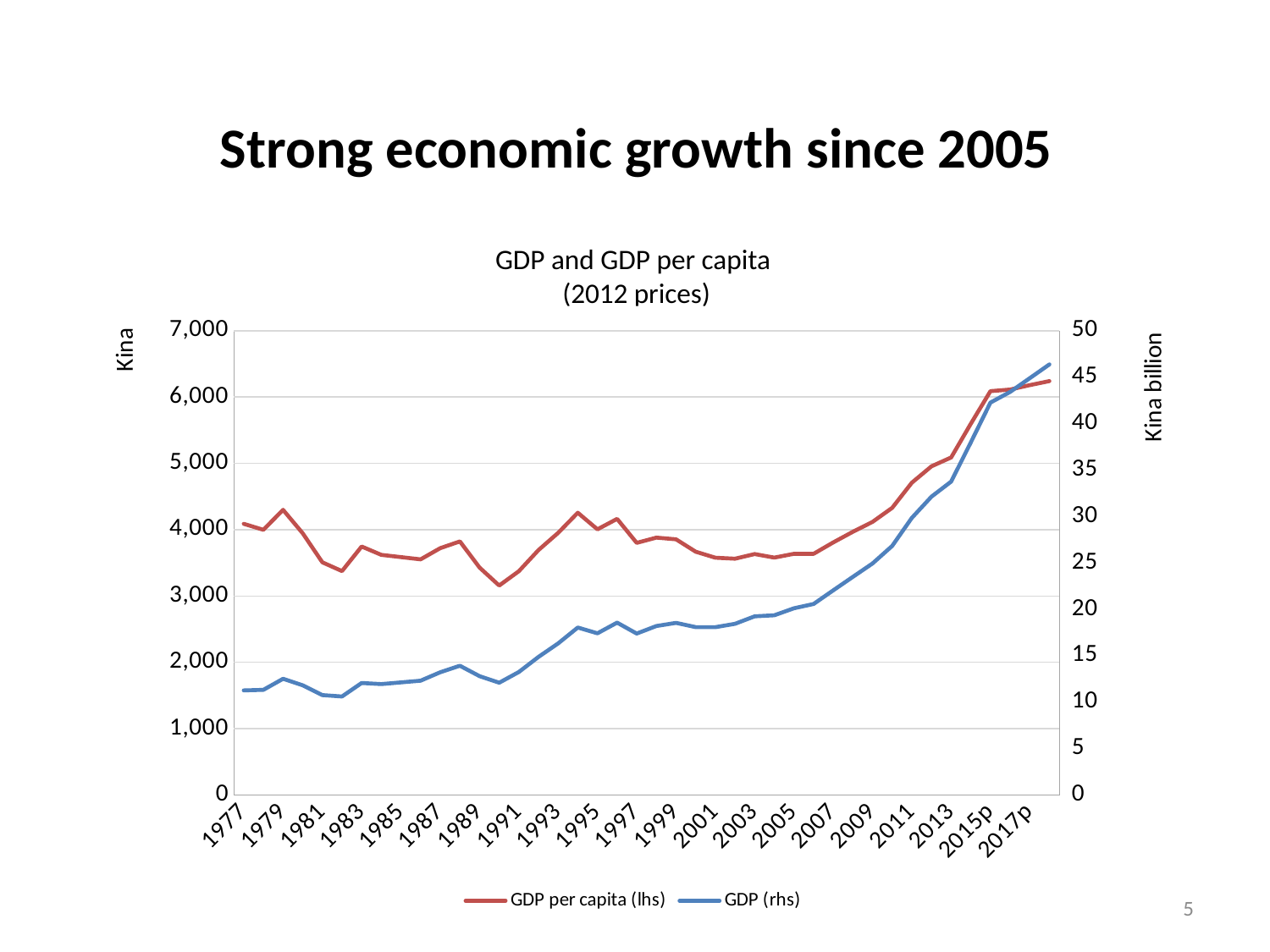
What is the title of the chart? GDP and GDP per capita (2012 prices) Is the value for GDP (rhs) in 1977 greater or less than 15? less What is the label of the right-hand vertical axis? Kina billion Is the value for GDP (rhs) in 2017p greater or less than 40? greater Is the value for GDP per capita (lhs) in 1991 greater or less than 4,000? less Does GDP (rhs) rise or fall between 2005 and 2017p? rise What kind of chart is shown on the slide? line chart How many series does the legend list? 2 In which year is GDP per capita (lhs) at its lowest? 1990